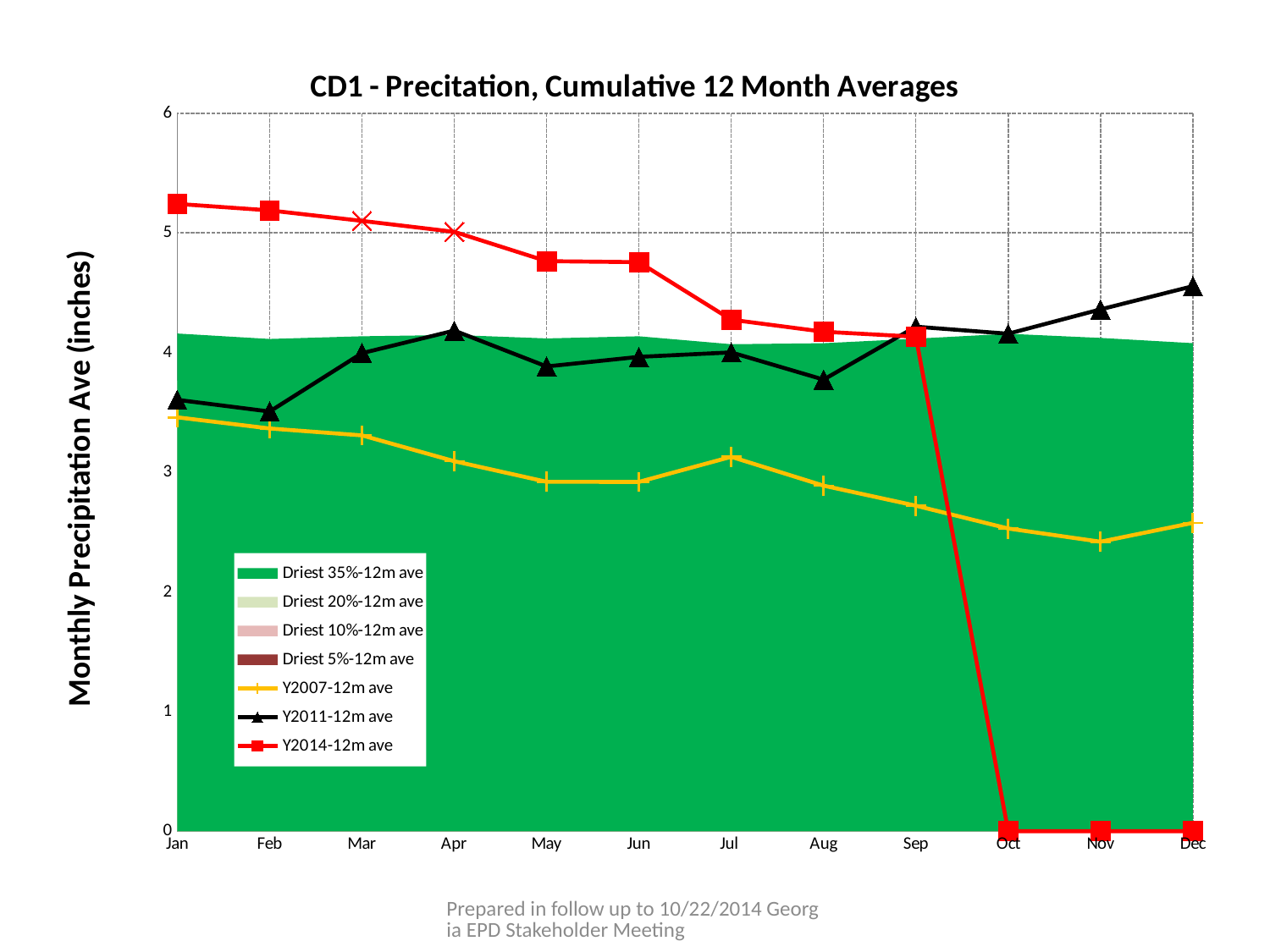
What kind of chart is shown on the slide? combination area and line chart Is the value for Y2014-12m ave in Oct greater or less than 1? less In which month is the Y2011-12m ave series highest? Dec In Jan, which is larger: Y2014-12m ave or Y2007-12m ave? Y2014-12m ave How many series does the legend list? 7 Is the value for Y2007-12m ave in Nov greater or less than 3? less Does the Y2007-12m ave series generally rise or fall from Jan to Nov? fall In which month is the Y2014-12m ave series highest? Jan Is the value for Y2011-12m ave in Dec greater or less than 4? greater What is the title of the chart? CD1 - Precitation, Cumulative 12 Month Averages How many months are shown along the x axis? 12